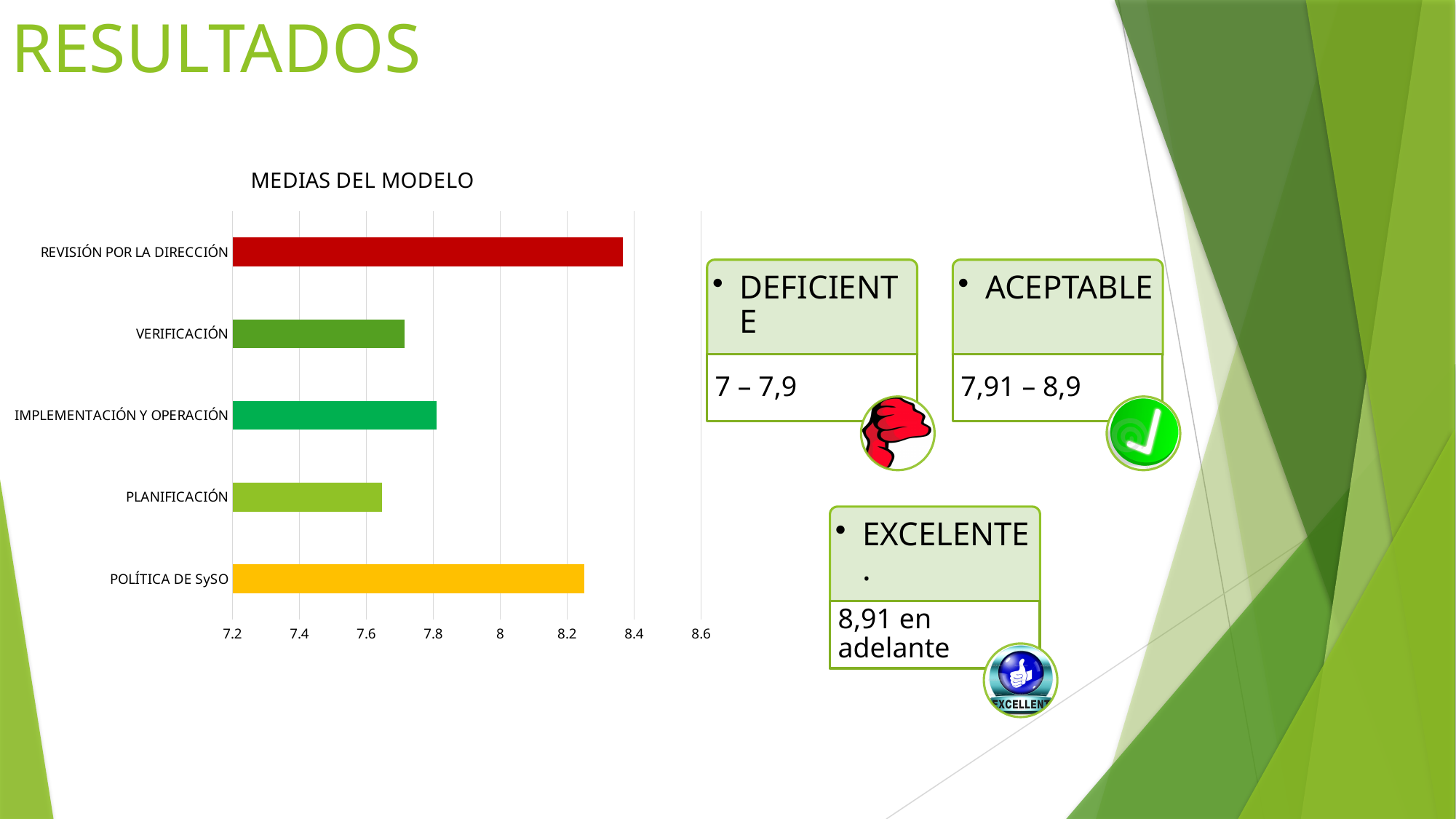
What colour is the bar for POLÍTICA DE SySO? yellow Is the value for VERIFICACIÓN greater or less than 7.8? less Which category has the lowest value in the chart? PLANIFICACIÓN Is the value for POLÍTICA DE SySO greater or less than 8? greater What is the title of the chart? MEDIAS DEL MODELO How many categories are plotted in the chart? 5 What kind of chart is shown on the slide? bar chart Is the value for PLANIFICACIÓN greater or less than 7.8? less Which has a larger value, VERIFICACIÓN or IMPLEMENTACIÓN Y OPERACIÓN? IMPLEMENTACIÓN Y OPERACIÓN Which has a larger value, REVISIÓN POR LA DIRECCIÓN or POLÍTICA DE SySO? REVISIÓN POR LA DIRECCIÓN Which category has the highest value in the chart? REVISIÓN POR LA DIRECCIÓN